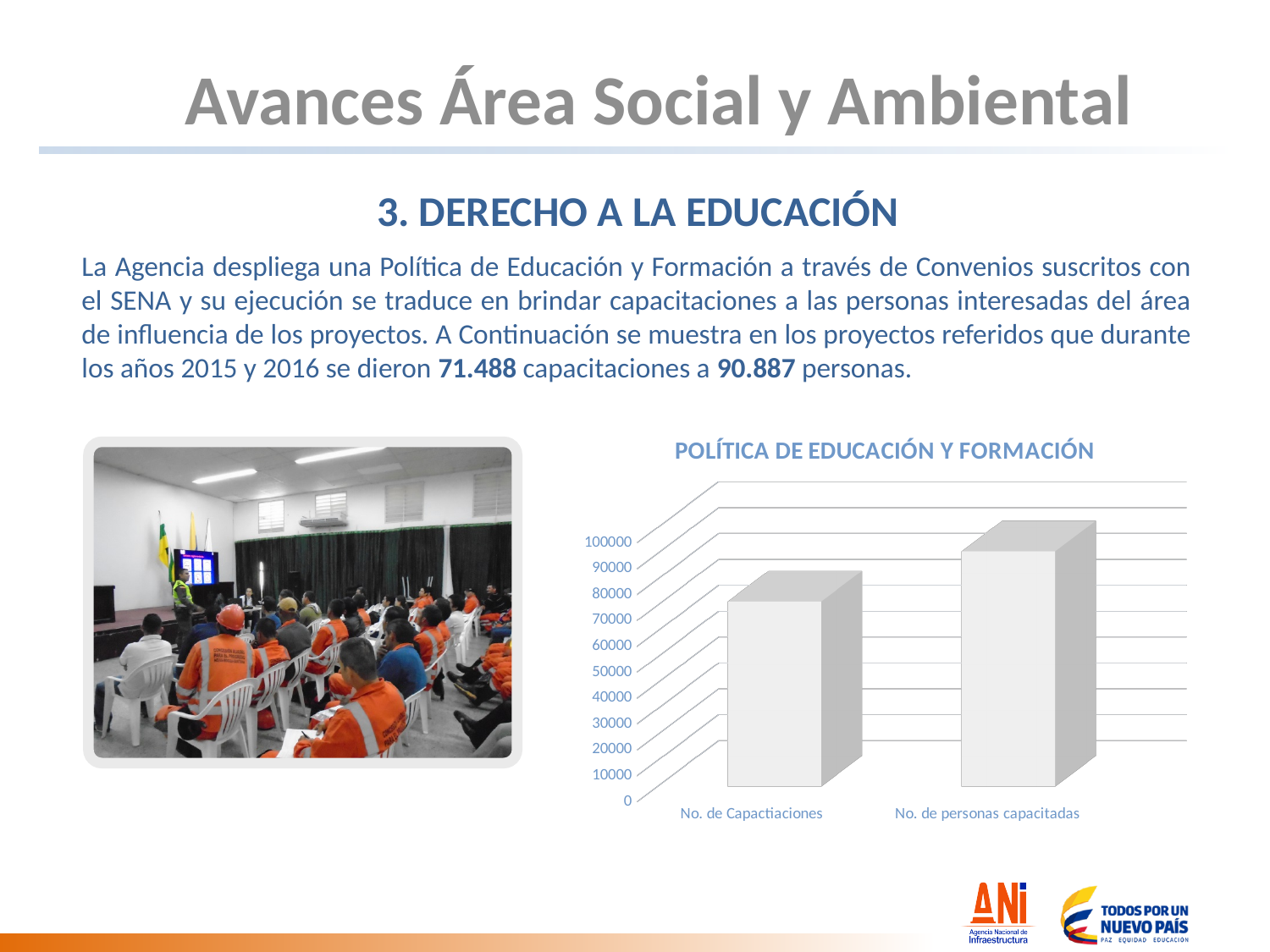
What is the highest tick value shown on the vertical axis of the chart? 100000 Do the bars rise or fall from left to right across the x axis? rise What kind of chart is shown on the slide? bar chart What is the title of the chart? POLÍTICA DE EDUCACIÓN Y FORMACIÓN Which category has the highest bar in the chart? No. de personas capacitadas Is the value for No. de Capactiaciones greater or less than 90000? less Which is larger, the bar for No. de Capactiaciones or the bar for No. de personas capacitadas? No. de personas capacitadas Is the value for No. de personas capacitadas greater or less than 80000? greater How many categories are plotted in the chart? 2 Which category has the lowest bar in the chart? No. de Capactiaciones Is the value for No. de Capactiaciones greater or less than 60000? greater